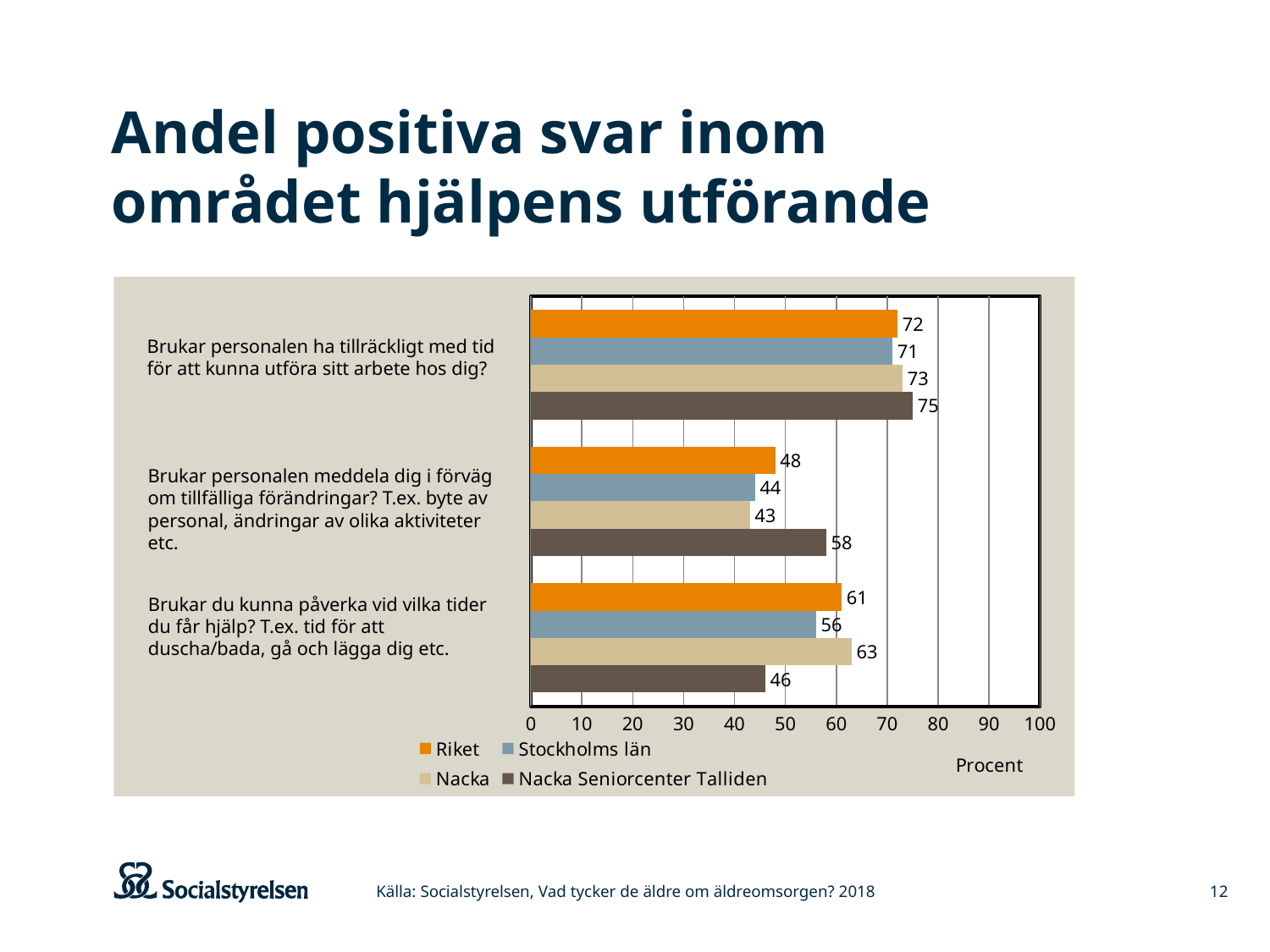
Which series has the lowest value for the question 'Brukar du kunna påverka vid vilka tider du får hjälp?' Nacka Seniorcenter Talliden What is the value for Nacka Seniorcenter Talliden for the question 'Brukar personalen ha tillräckligt med tid för att kunna utföra sitt arbete hos dig?' 75 What label is shown on the x axis of the chart? Procent What is the value for Stockholms län for the question 'Brukar du kunna påverka vid vilka tider du får hjälp?' 56 What is the difference between Nacka Seniorcenter Talliden and Nacka for the question 'Brukar personalen meddela dig i förväg om tillfälliga förändringar?' 15 How many series does the legend list? 4 What is the value for Riket for the question 'Brukar personalen meddela dig i förväg om tillfälliga förändringar?' 48 What type of chart is shown on the slide? Bar chart What is the difference between Riket and Stockholms län for the question 'Brukar du kunna påverka vid vilka tider du får hjälp?' 5 For the question 'Brukar du kunna påverka vid vilka tider du får hjälp?', which is larger: the value for Nacka or the value for Riket? Nacka Which series has the highest value for the question 'Brukar personalen meddela dig i förväg om tillfälliga förändringar?' Nacka Seniorcenter Talliden How many question categories are shown on the y axis of the chart? 3